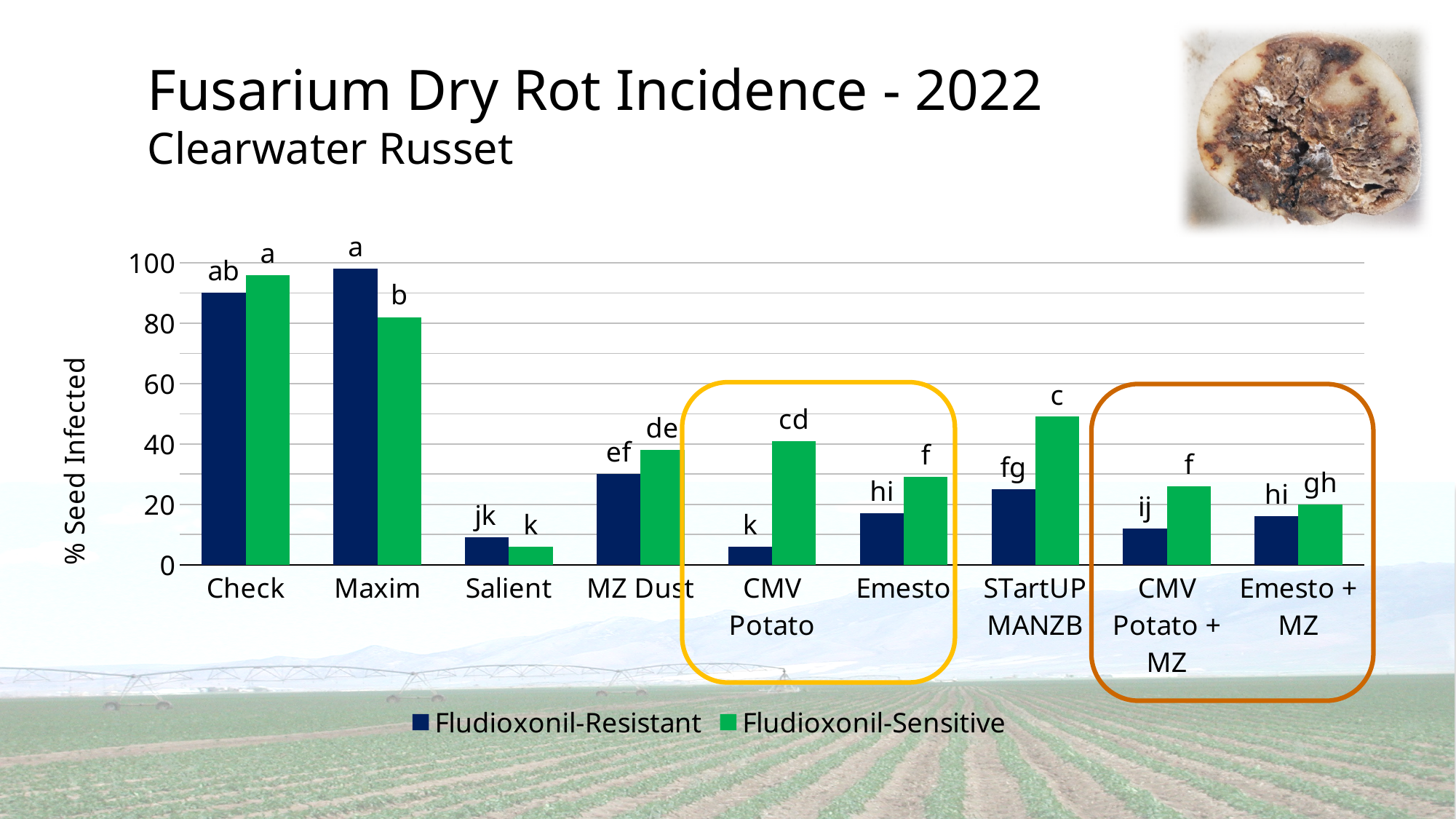
What kind of chart is shown on the slide? bar chart How many treatment categories are shown on the x axis? 9 Is the Fludioxonil-Resistant value for Check greater or less than 80? greater What is the label on the y axis of the chart? % Seed Infected Which treatment has the highest Fludioxonil-Sensitive value? Check For CMV Potato, which series has the larger value, Fludioxonil-Resistant or Fludioxonil-Sensitive? Fludioxonil-Sensitive How many series does the legend list? 2 Which treatment has the lowest Fludioxonil-Sensitive value? Salient Is the Fludioxonil-Sensitive value for Salient greater or less than 20? less For Maxim, which series has the larger value, Fludioxonil-Resistant or Fludioxonil-Sensitive? Fludioxonil-Resistant Is the Fludioxonil-Sensitive value for STartUP MANZB greater or less than 40? greater Which treatment has the highest Fludioxonil-Resistant value? Maxim